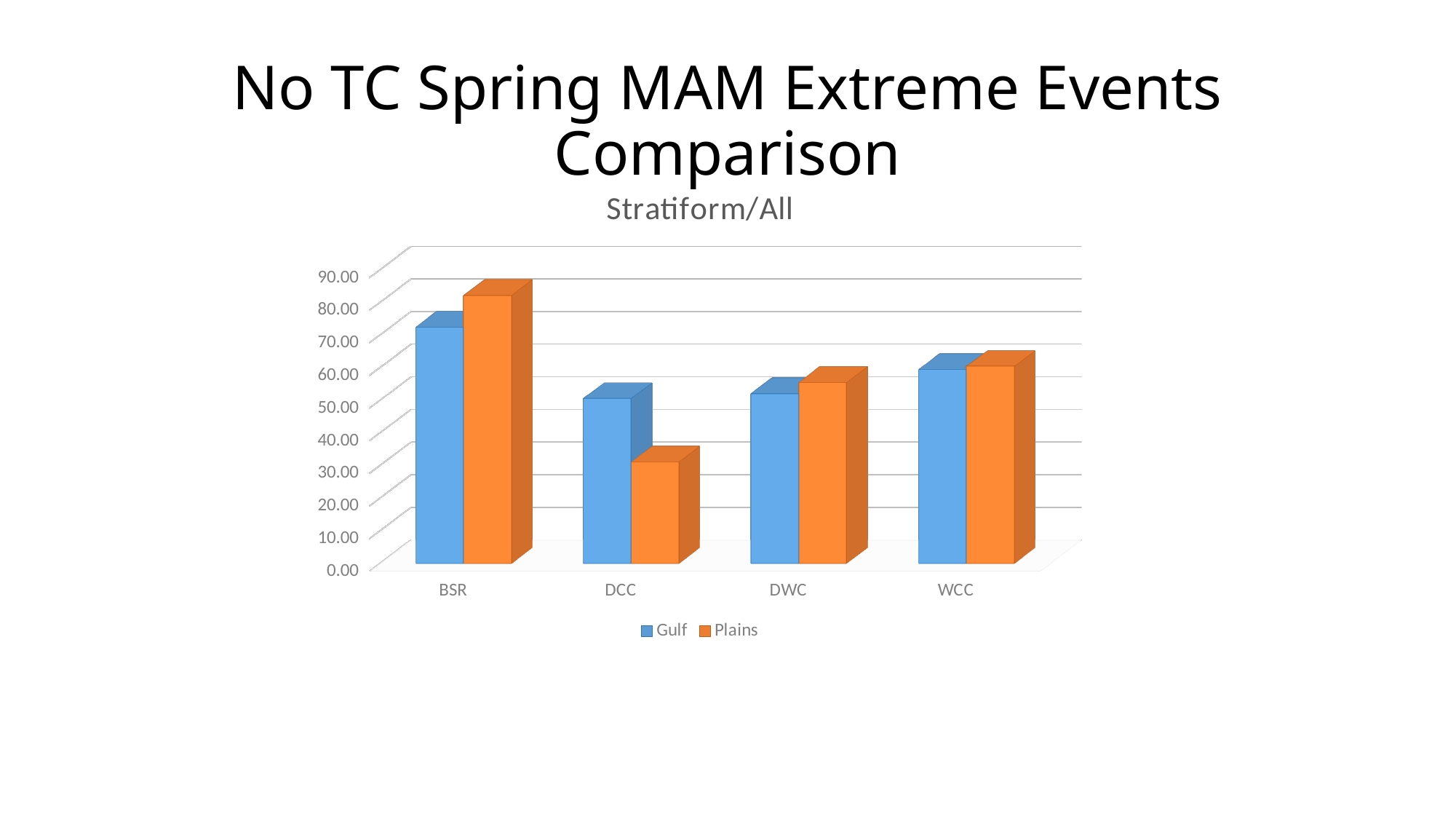
Which category has the highest Gulf value? BSR What kind of chart is shown on the slide? bar chart Which category has the lowest Plains value? DCC How many series does the chart's legend list? 2 For DCC, which is larger, the Gulf value or the Plains value? Gulf Is the Plains value for DCC greater or less than 40.00? less What is the title shown directly above the chart? Stratiform/All How many categories are shown on the x axis of the chart? 4 For BSR, which is larger, the Gulf value or the Plains value? Plains Is the Gulf value for BSR greater or less than 60.00? greater Which two series are listed in the chart's legend? Gulf and Plains Which category has the highest Plains value? BSR